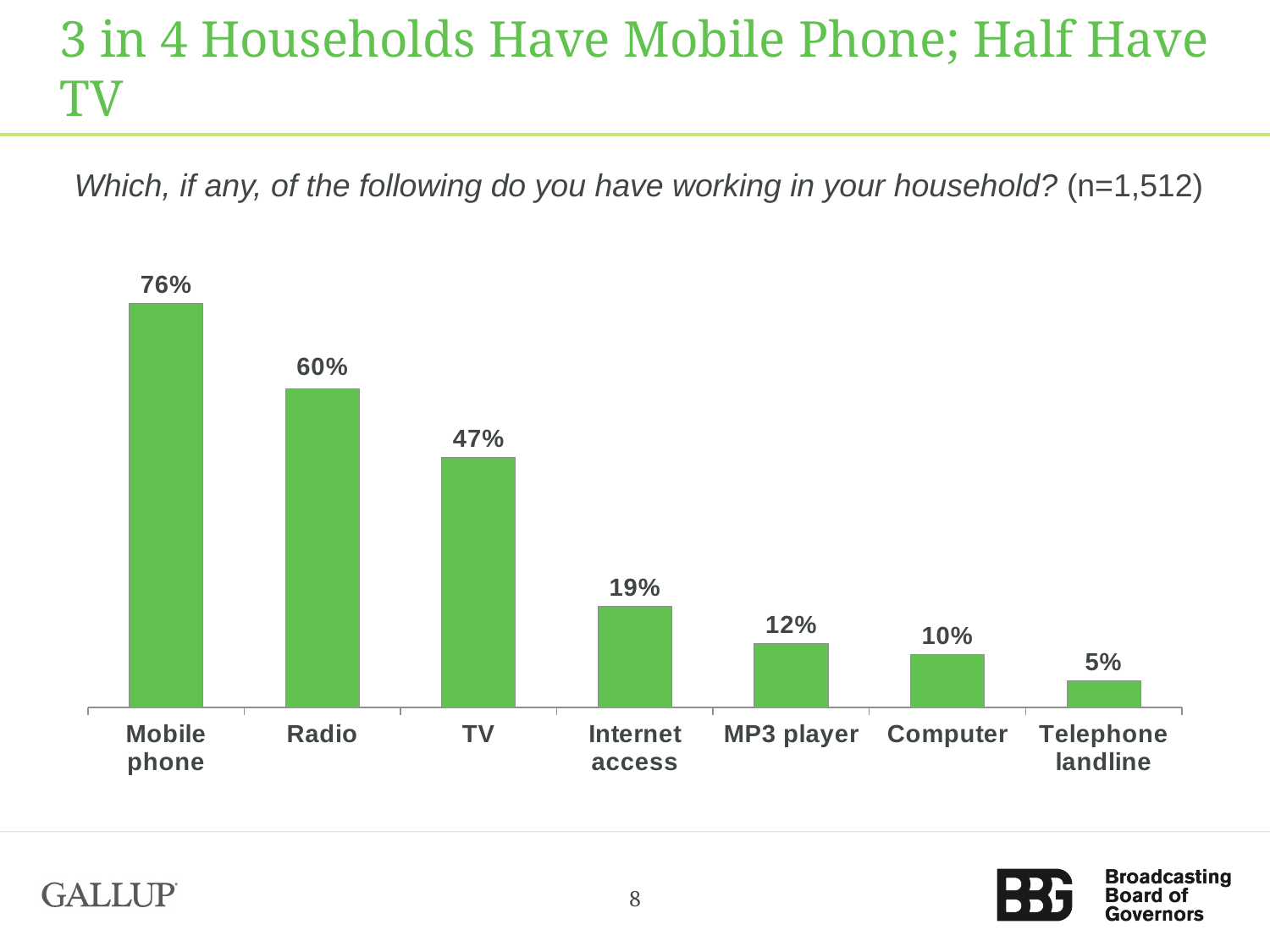
Do the values rise or fall from left to right across the categories? Fall What kind of chart is shown on the slide? Bar chart Which is larger, the value for MP3 player or the value for Computer? MP3 player What is the value shown for Radio? 60% Which category has the lowest value? Telephone landline What is the difference between the values for Mobile phone and TV? 29% How many categories are shown on the chart? 7 What percentage of households have a working mobile phone? 76% What is the difference between the values for Internet access and Computer? 9% Which category has the highest value? Mobile phone What is the value shown for Telephone landline? 5% What percentage of households have a working TV? 47%